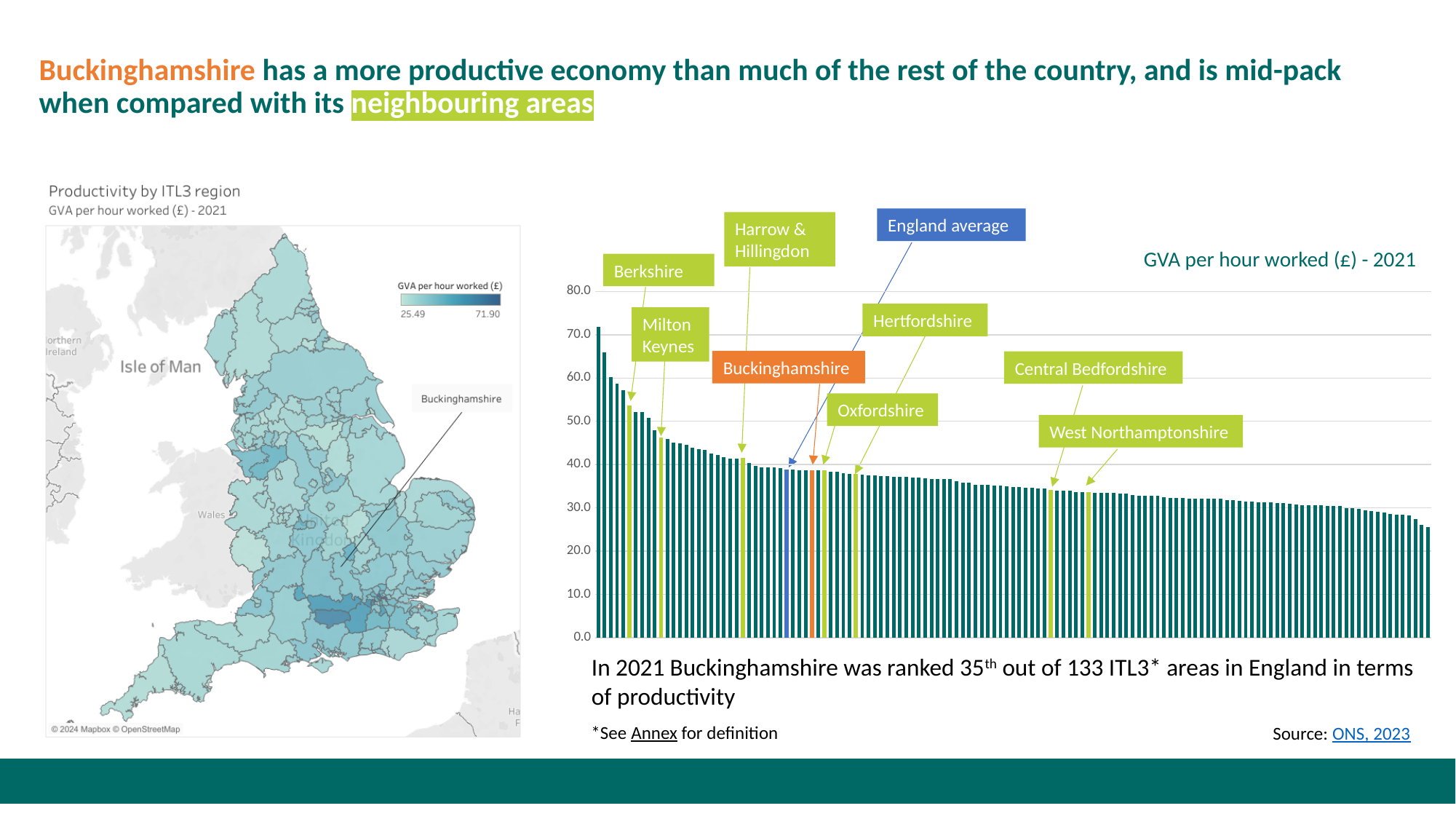
In the bar chart, is the value for Milton Keynes greater or less than 40? greater In the bar chart, which has the higher value, Berkshire or Milton Keynes? Berkshire In the bar chart, is the value for Berkshire greater or less than 50? greater What colour is the Buckinghamshire bar in the bar chart? orange What kind of chart is the chart on the right of the slide? bar chart In the bar chart, is the value for West Northamptonshire greater or less than 40? less In the bar chart, which has the higher value, Central Bedfordshire or Berkshire? Berkshire What is the title of the map chart on the left of the slide? Productivity by ITL3 region According to the slide, how many ITL3 areas in England are ranked in the bar chart? 133 Do the bars in the bar chart rise or fall from left to right? fall